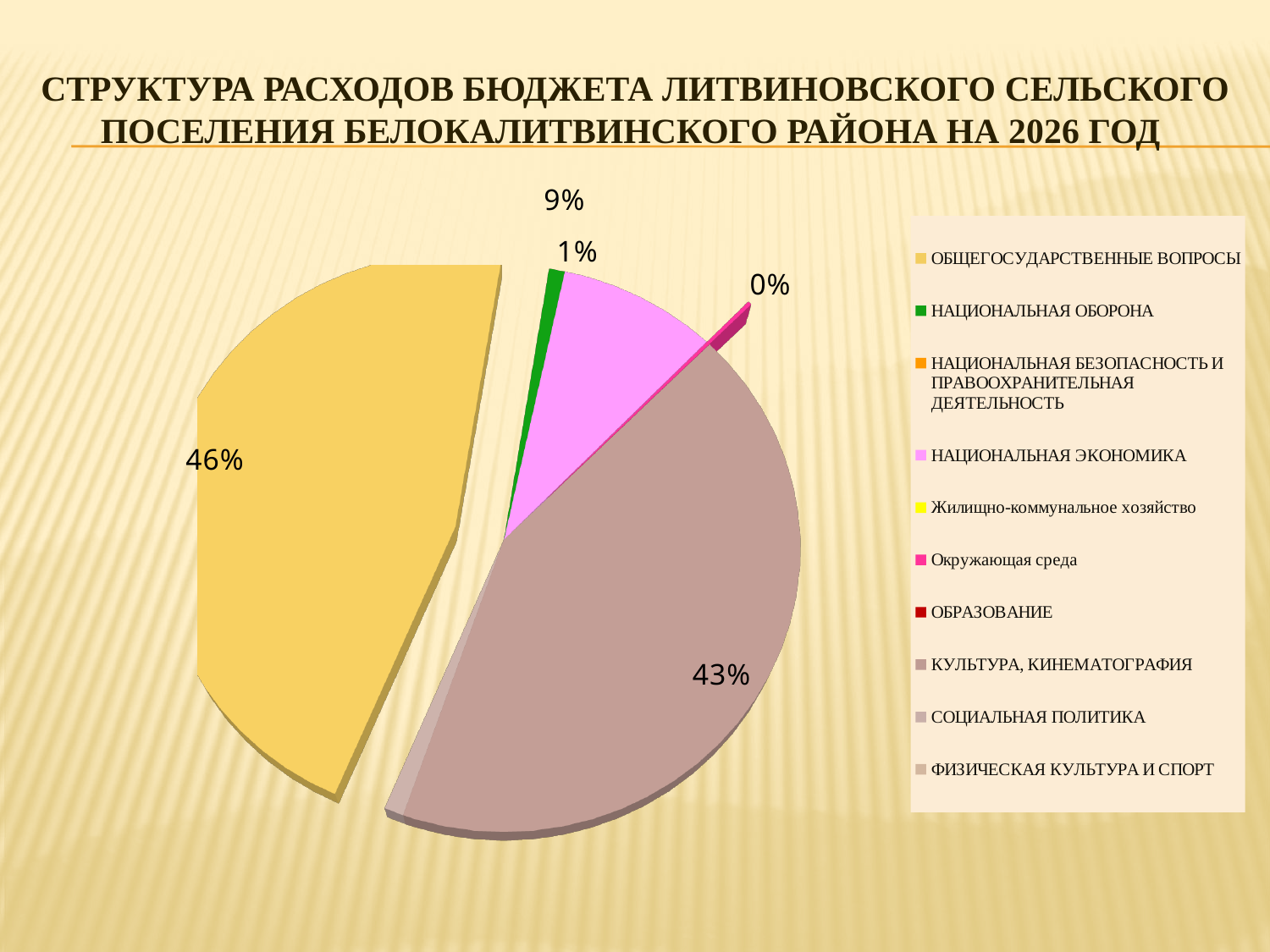
Which category has the largest share of the pie? ОБЩЕГОСУДАРСТВЕННЫЕ ВОПРОСЫ By how many percentage points does the share of ОБЩЕГОСУДАРСТВЕННЫЕ ВОПРОСЫ exceed that of КУЛЬТУРА, КИНЕМАТОГРАФИЯ? 3 percentage points What share of the budget expenditure is labelled for НАЦИОНАЛЬНАЯ ЭКОНОМИКА? 9% What share of the budget expenditure is labelled for Окружающая среда? 0% What share of the budget expenditure is labelled for КУЛЬТУРА, КИНЕМАТОГРАФИЯ? 43% What type of chart is shown on the slide? Pie chart Which has a larger share: НАЦИОНАЛЬНАЯ ЭКОНОМИКА or НАЦИОНАЛЬНАЯ ОБОРОНА? НАЦИОНАЛЬНАЯ ЭКОНОМИКА What colour is the slice for ОБЩЕГОСУДАРСТВЕННЫЕ ВОПРОСЫ? Yellow What share of the budget expenditure is labelled for НАЦИОНАЛЬНАЯ ОБОРОНА? 1% Which labelled slice has the smallest share of the pie? Окружающая среда What share of the budget expenditure is labelled for ОБЩЕГОСУДАРСТВЕННЫЕ ВОПРОСЫ? 46% How many categories are listed in the chart legend? 10